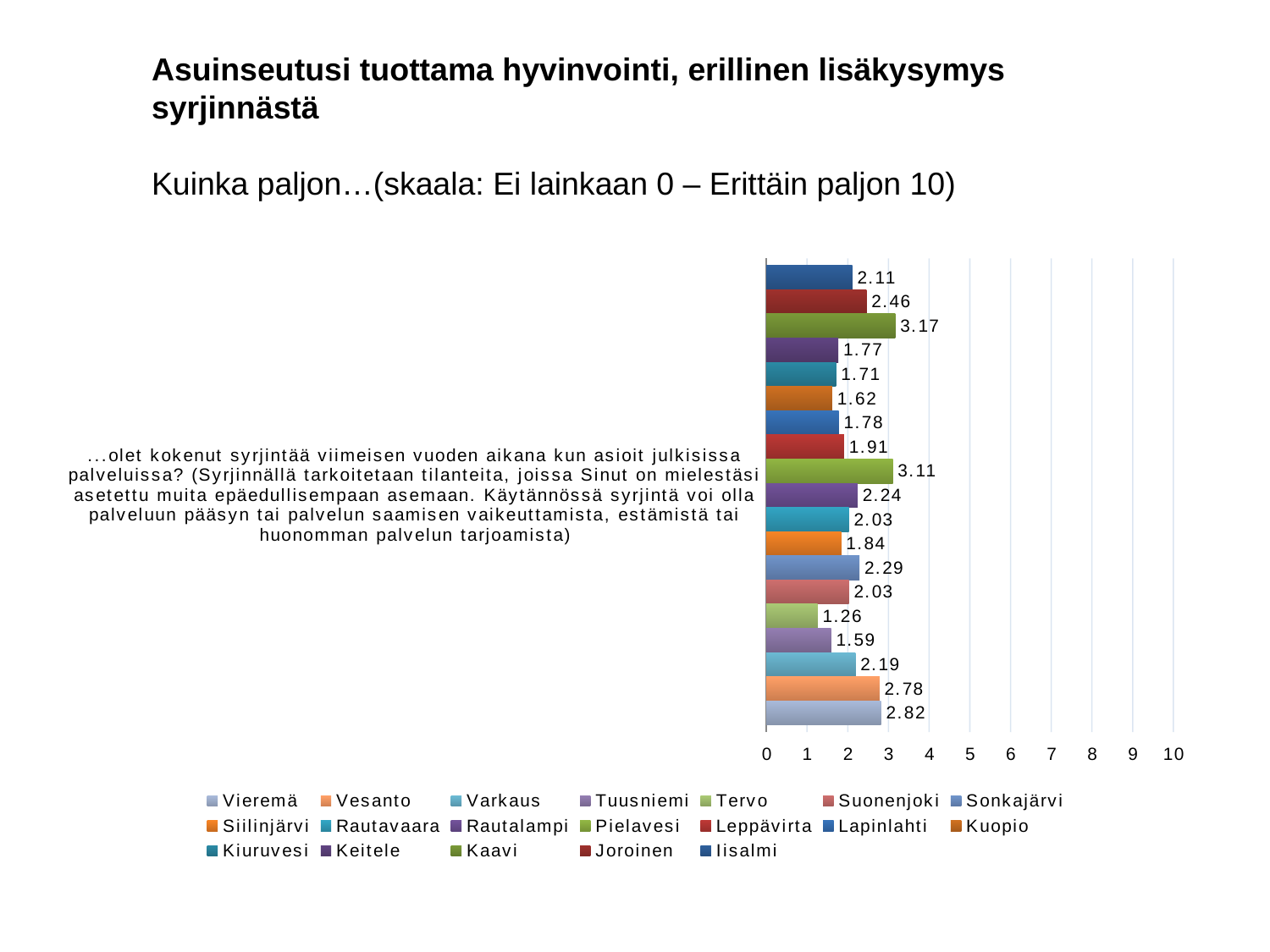
Which is larger, the value for Joroinen or the value for Iisalmi? Joroinen How many series does the legend list? 19 What is the difference between the values for Vieremä and Vesanto? 0.04 What is the value for Tervo? 1.26 What is the value for Vieremä? 2.82 What is the value for Kaavi? 3.17 What is the maximum value shown on the horizontal axis? 10 What kind of chart is shown on the slide? bar chart Which municipality has the highest value? Kaavi Is the value for Kuopio greater or less than 2? less Which municipality has the lowest value? Tervo What is the value for Pielavesi? 3.11